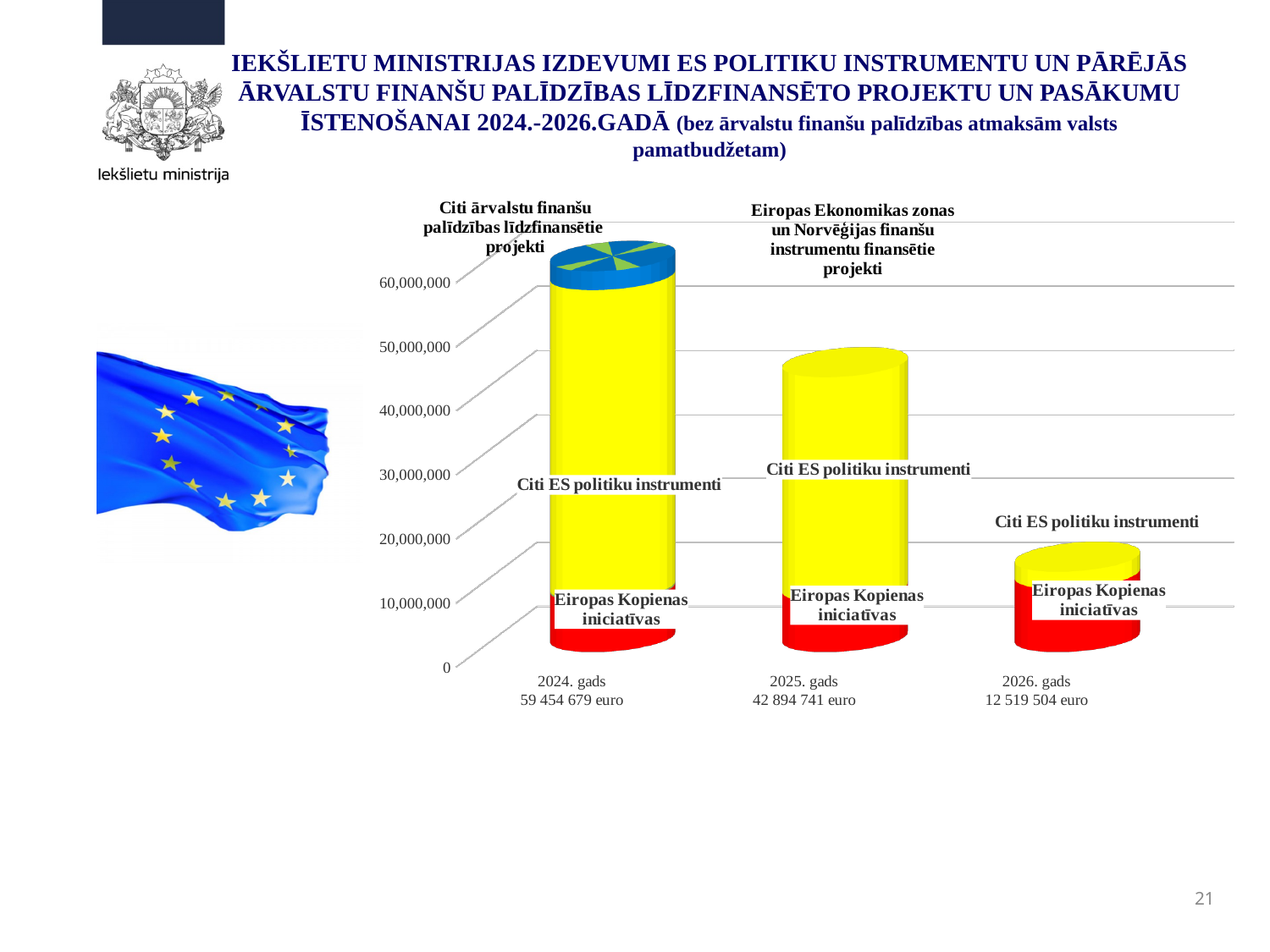
Is the total for 2025. gads greater or less than 50,000,000? less Which is larger, the total for 2025. gads or the total for 2026. gads? 2025. gads What is the total value shown for 2025. gads? 42 894 741 euro What is the total value shown for 2024. gads? 59 454 679 euro What is the difference between the totals for 2025. gads and 2026. gads? 30 375 237 euro How many years (categories) are shown on the x axis? 3 Do the total values rise or fall from 2024. gads to 2026. gads? Fall What is the difference between the totals for 2024. gads and 2025. gads? 16 559 938 euro Which year has the highest total value? 2024. gads What is the total value shown for 2026. gads? 12 519 504 euro Which year has the lowest total value? 2026. gads What kind of chart is shown on the slide? Stacked bar chart